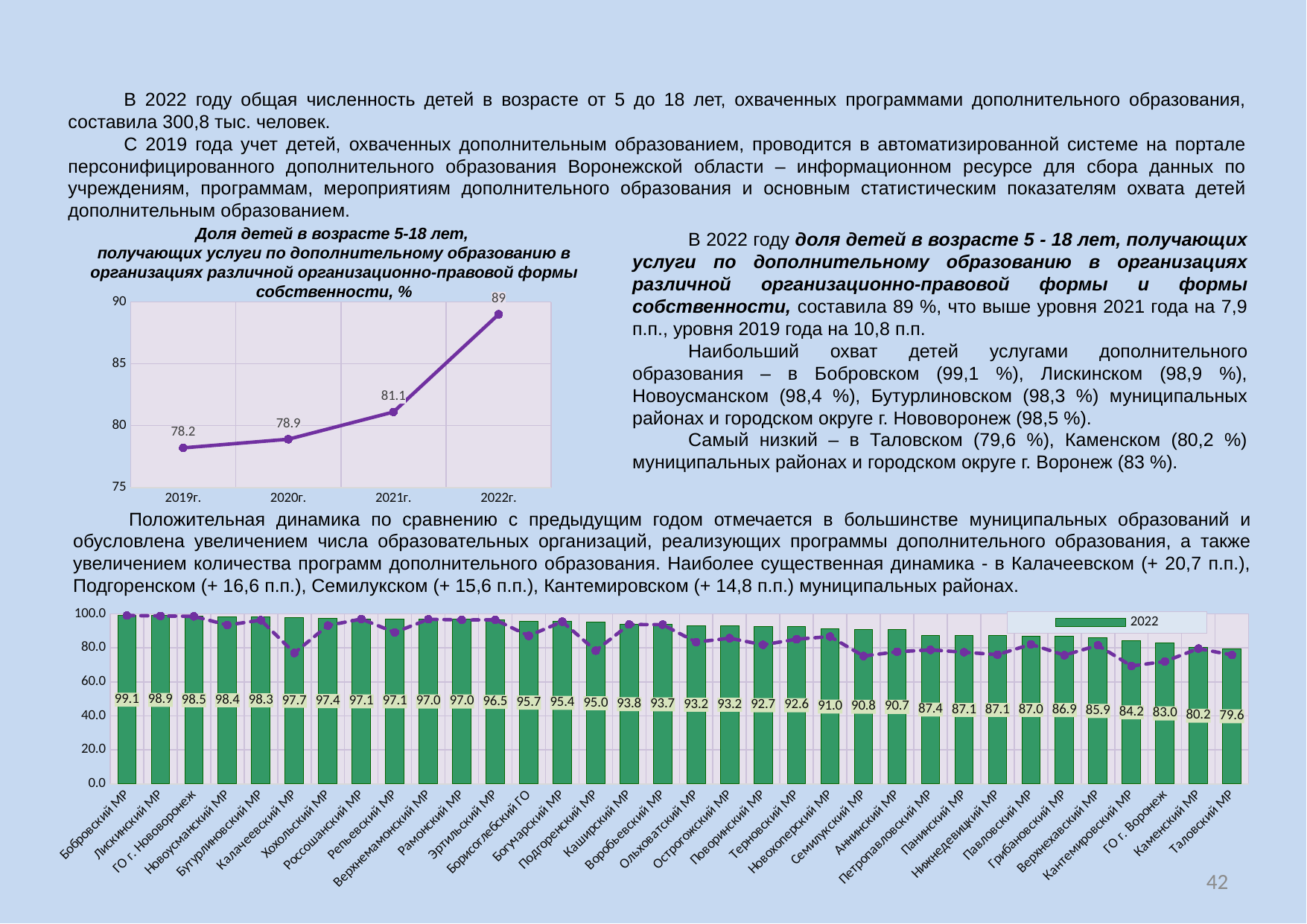
In the line chart at the top left, what is the value for 2022г.? 89 In the line chart at the top left, by how much did the value increase from 2021г. to 2022г.? 7.9 In the bar chart at the bottom, which municipality has the highest value? Бобровский МР In the bar chart at the bottom, what is the value for ГО г. Воронеж? 83.0 In the line chart at the top left, what is the value for 2021г.? 81.1 In the line chart at the top left, how many years are plotted? 4 In the bar chart at the bottom, what is the difference between the values for Бобровский МР and Таловский МР? 19.5 In the line chart at the top left, what is the value for 2019г.? 78.2 In the bar chart at the bottom, what year does the legend entry for the green bars show? 2022 In the bar chart at the bottom, what is the value for Калачеевский МР? 97.7 In the line chart at the top left, do the values rise or fall from 2019г. to 2022г.? rise In the bar chart at the bottom, which municipality has the lowest value? Таловский МР